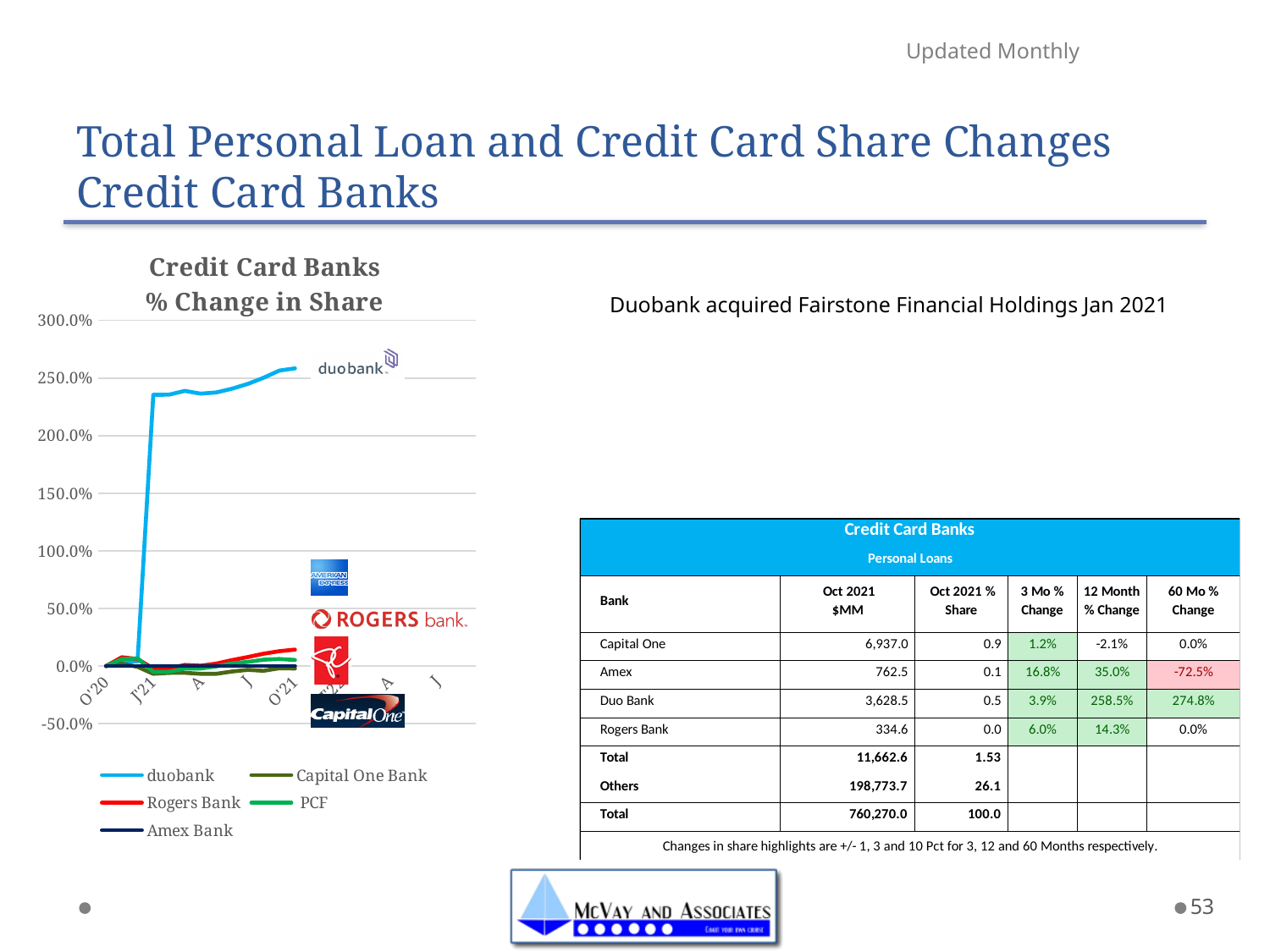
What kind of chart is shown on the slide? line chart How many series does the legend of the chart list? 5 Is the value for duobank at O'20 greater or less than 50.0%? less Is the value for duobank at O'21 greater or less than 150.0%? greater At O'21, which is larger: the value for duobank or the value for Rogers Bank? duobank Does the duobank line rise or fall from O'20 to O'21? rises Is the value for duobank at J'21 greater or less than 200.0%? greater What is the highest value shown on the chart's vertical axis? 300.0% What is the title of the chart? Credit Card Banks % Change in Share Which series reaches the highest value on the chart? duobank